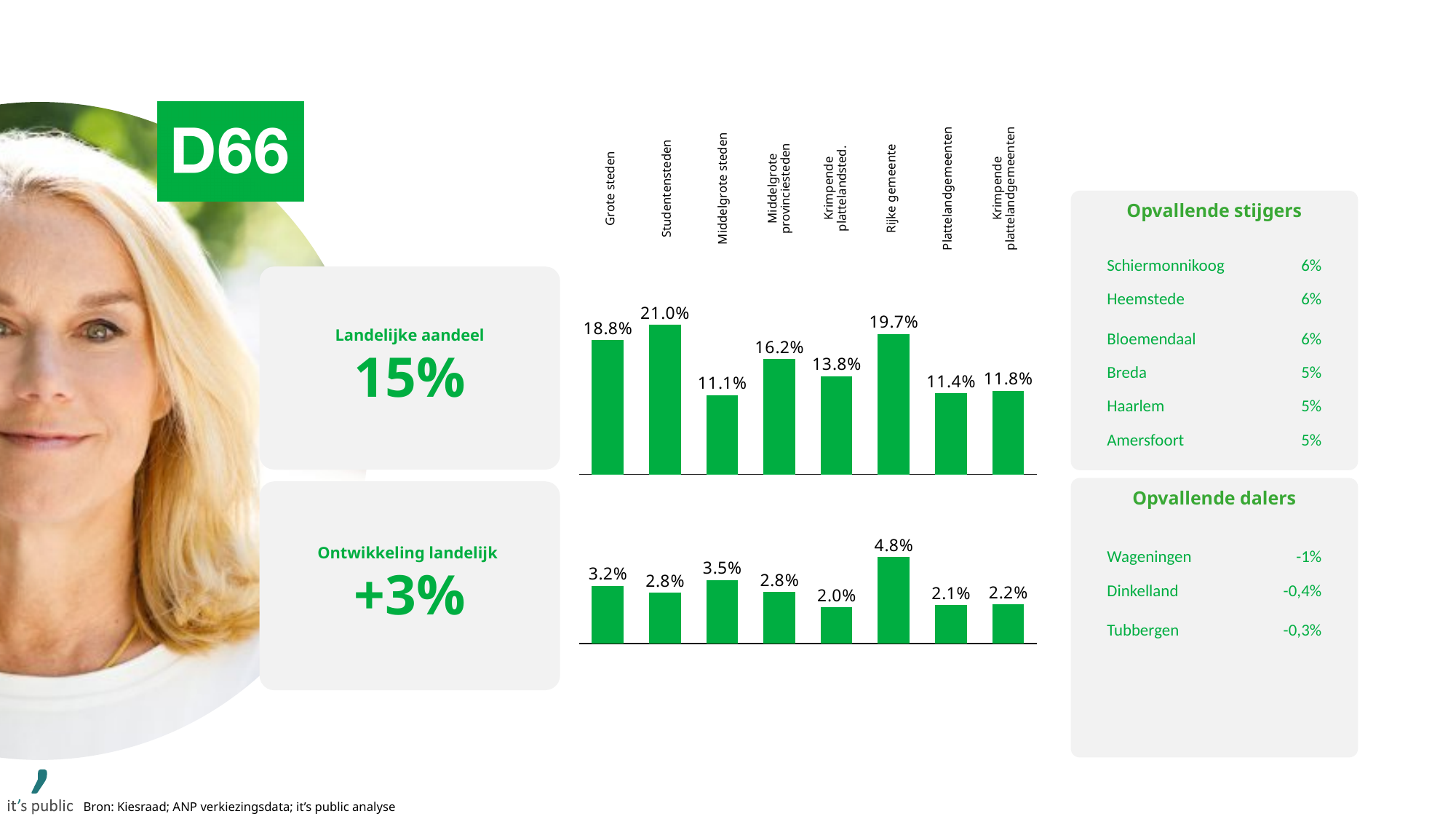
In the bottom chart (next to 'Ontwikkeling landelijk'), which is larger: Grote steden or Middelgrote steden? Middelgrote steden In the top chart (next to 'Landelijke aandeel'), which category has the lowest value? Middelgrote steden In the top chart (next to 'Landelijke aandeel'), what is the value for Rijke gemeente? 19.7% In the top chart (next to 'Landelijke aandeel'), what is the value for Plattelandgemeenten? 11.4% In the bottom chart (next to 'Ontwikkeling landelijk'), which category has the highest value? Rijke gemeente In the top chart (next to 'Landelijke aandeel'), which category has the highest value? Studentensteden In the bottom chart (next to 'Ontwikkeling landelijk'), what is the difference between Rijke gemeente and Plattelandgemeenten? 2.7% In the top chart (next to 'Landelijke aandeel'), what is the value for Studentensteden? 21.0% What kind of chart is the bottom chart (next to 'Ontwikkeling landelijk')? Bar chart How many categories are shown in the top chart (next to 'Landelijke aandeel')? 8 In the top chart (next to 'Landelijke aandeel'), what is the difference between Grote steden and Middelgrote steden? 7.7% In the bottom chart (next to 'Ontwikkeling landelijk'), what is the value for Krimpende plattelandsted.? 2.0%